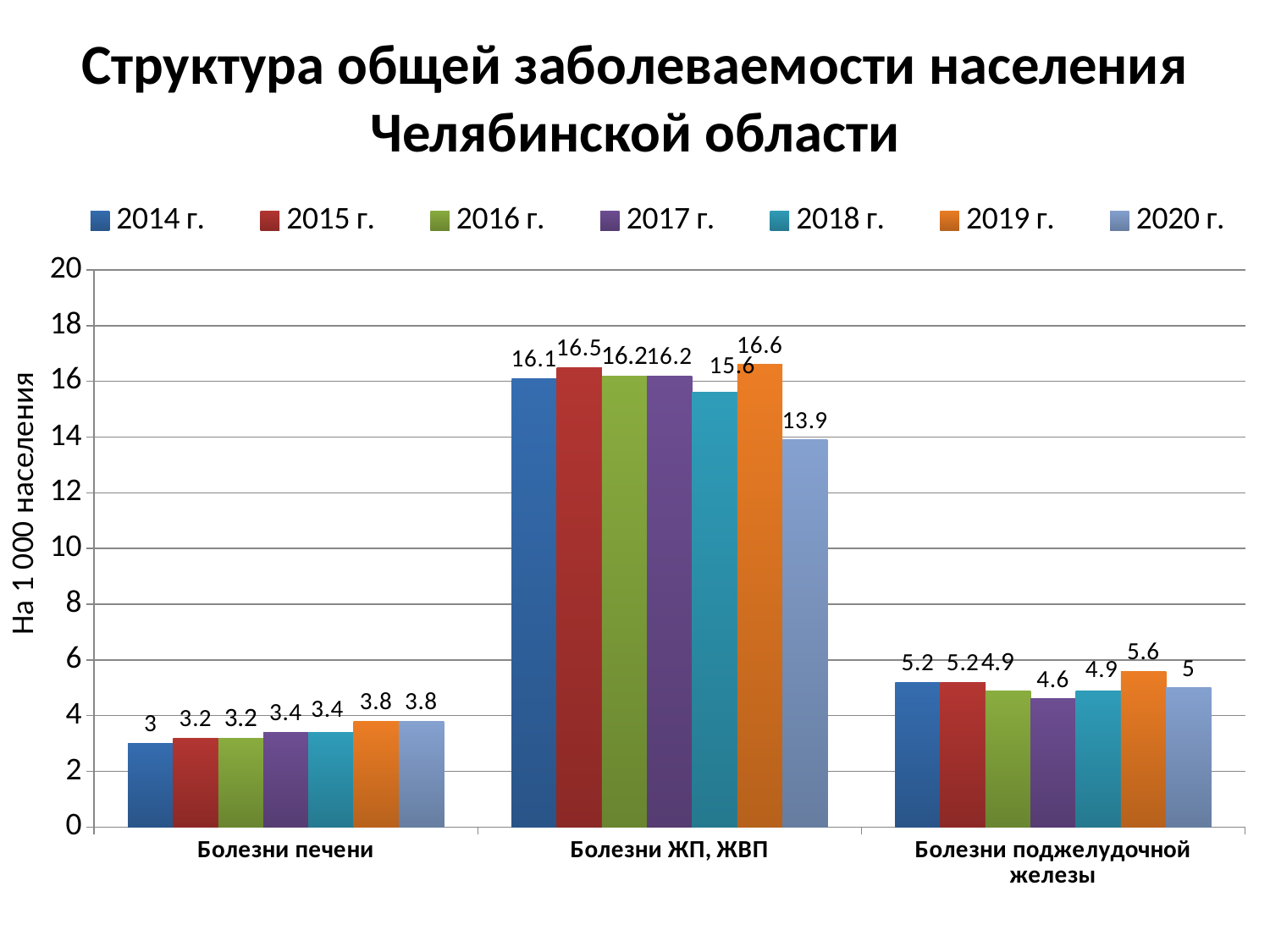
Is the value for Болезни ЖП, ЖВП in 2018 г. greater or less than 14? greater What is the value for Болезни ЖП, ЖВП in 2020 г.? 13.9 What is the value for Болезни поджелудочной железы in 2019 г.? 5.6 How many categories are shown on the x axis? 3 How many series does the legend list? 7 Which is larger for Болезни печени: the value for 2014 г. or the value for 2020 г.? 2020 г. What is the difference between the 2019 г. and 2020 г. values for Болезни ЖП, ЖВП? 2.7 What is the value for Болезни печени in 2014 г.? 3 What is the label of the vertical axis? На 1 000 населения Which year has the highest value for Болезни ЖП, ЖВП? 2019 г. Which year has the lowest value for Болезни поджелудочной железы? 2017 г. What type of chart is shown on the slide? Bar chart